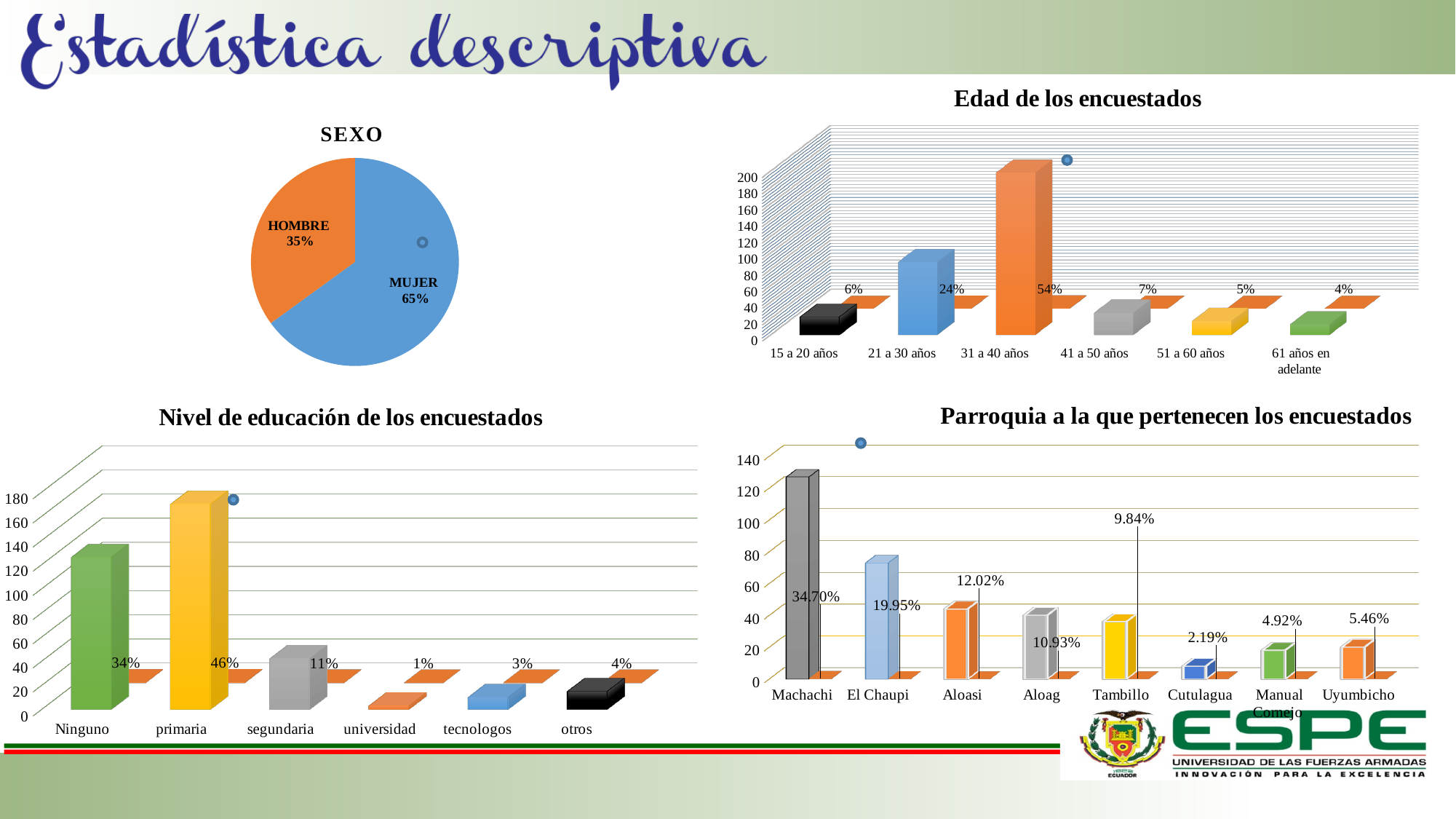
In the 'Edad de los encuestados' chart, how many age categories are shown? 6 In the SEXO pie chart, what is the difference between the MUJER and HOMBRE shares? 30% In the 'Parroquia a la que pertenecen los encuestados' chart, what percentage is labelled for Tambillo? 9.84% In the 'Edad de los encuestados' chart, what percentage is labelled for 31 a 40 años? 54% In the 'Parroquia a la que pertenecen los encuestados' chart, what is the difference between the labelled percentages for Machachi and El Chaupi? 14.75% In the 'Parroquia a la que pertenecen los encuestados' chart, which parroquia has the lowest labelled percentage? Cutulagua In the 'Nivel de educación de los encuestados' chart, which category has the highest value? primaria In the SEXO pie chart, what percentage is labelled for MUJER? 65% In the 'Edad de los encuestados' chart, which age group has the lowest labelled percentage? 61 años en adelante In the 'Nivel de educación de los encuestados' chart, what percentage is labelled for Ninguno? 34% In the 'Nivel de educación de los encuestados' chart, is the bar for primaria greater or less than 140 on the vertical axis? greater In the 'Edad de los encuestados' chart, is the bar for 21 a 30 años greater or less than 60 on the vertical axis? greater